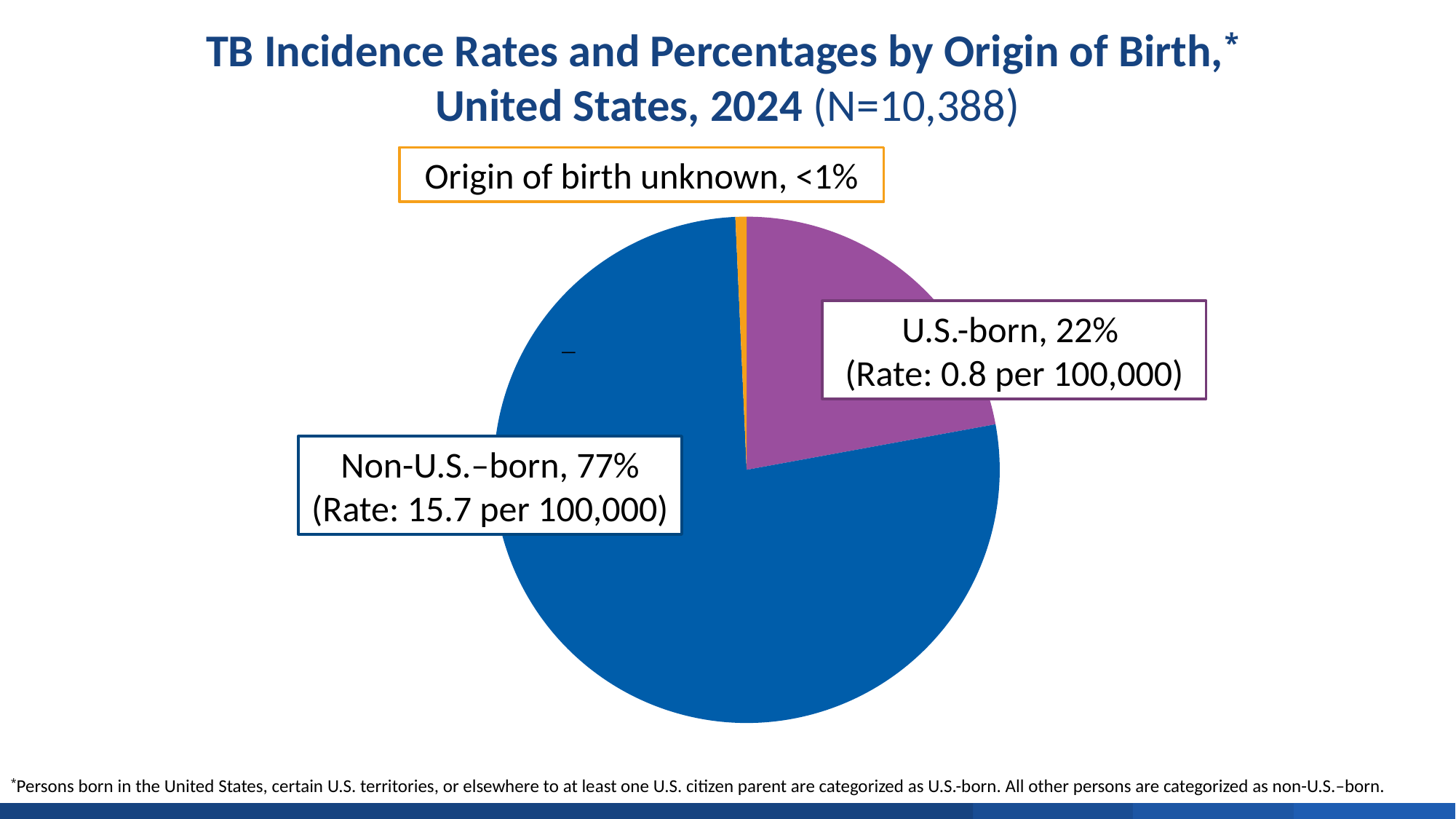
What is the difference in percentage points between the non-U.S.-born and U.S.-born shares? 55 percentage points Which origin-of-birth category accounts for the largest share of TB cases? Non-U.S.-born What percentage of TB cases were among U.S.-born persons? 22% Which origin-of-birth category accounts for the smallest share of TB cases? Origin of birth unknown What type of chart is shown on the slide? pie chart Which group has a higher TB incidence rate, U.S.-born or non-U.S.-born persons? Non-U.S.-born What is the TB incidence rate for non-U.S.-born persons? 15.7 per 100,000 What percentage of TB cases were among non-U.S.-born persons? 77% What is the total number of TB cases (N) stated in the chart title? 10,388 How many slices does the pie chart have? 3 What is the TB incidence rate for U.S.-born persons? 0.8 per 100,000 What percentage of cases had an unknown origin of birth? <1%